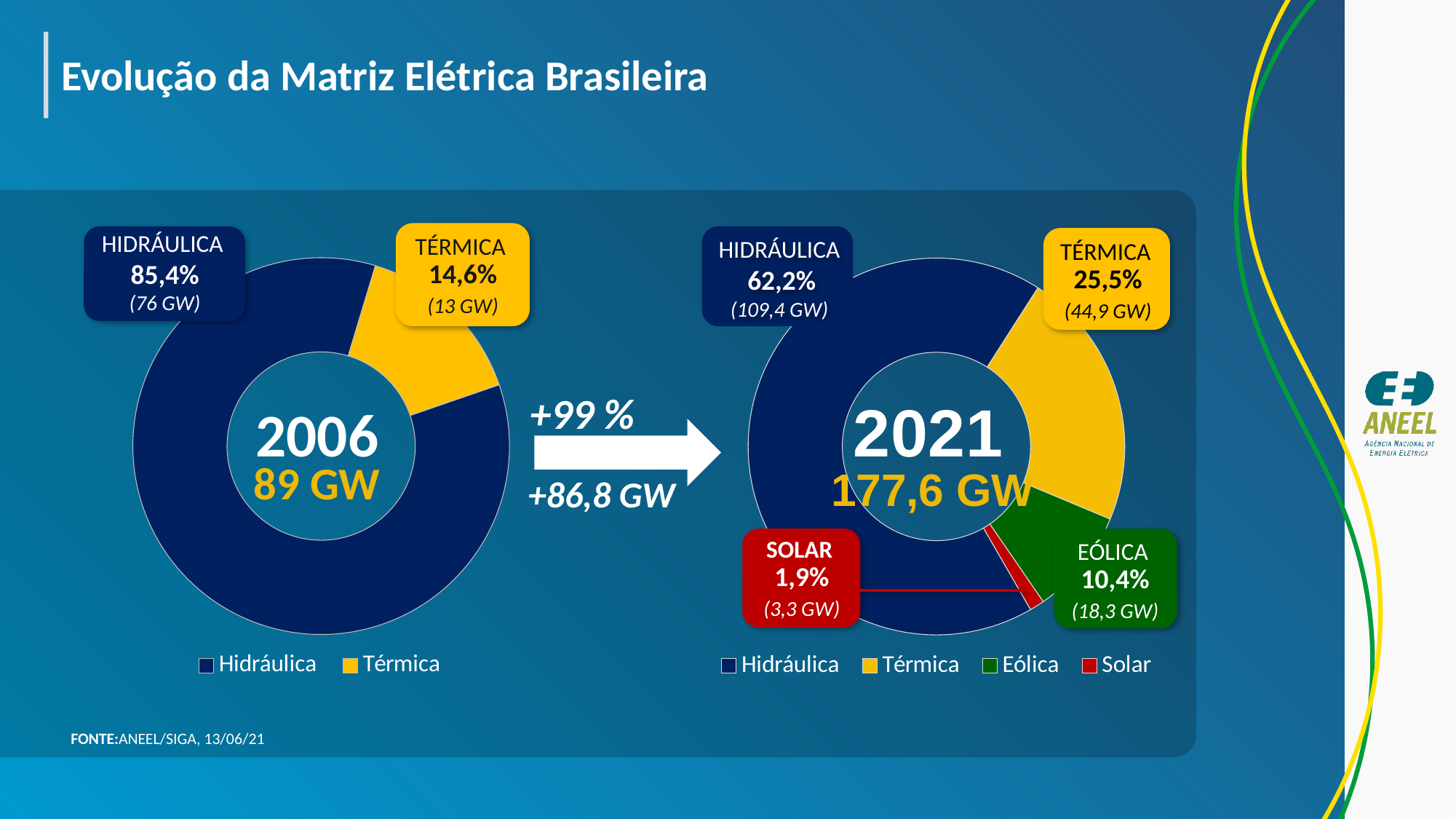
In the 2021 chart, what share of the matrix is Térmica? 25,5% In the 2021 chart, what is the difference in percentage points between Térmica and Eólica? 15,1 What kind of chart is used for the 2006 data? Doughnut chart In the 2021 chart, which is larger, the share of Eólica or the share of Solar? Eólica In the 2021 chart, how many GW does Eólica account for? 18,3 GW In the 2006 chart, how many GW does Térmica account for? 13 GW In the 2021 chart, which source has the smallest share? Solar In the 2021 chart, which source has the largest share? Hidráulica In the 2006 chart, what share of the matrix is Hidráulica? 85,4% How many entries does the legend of the 2006 chart list? 2 How many categories does the 2021 chart show? 4 What total capacity is shown in the centre of the 2021 chart? 177,6 GW